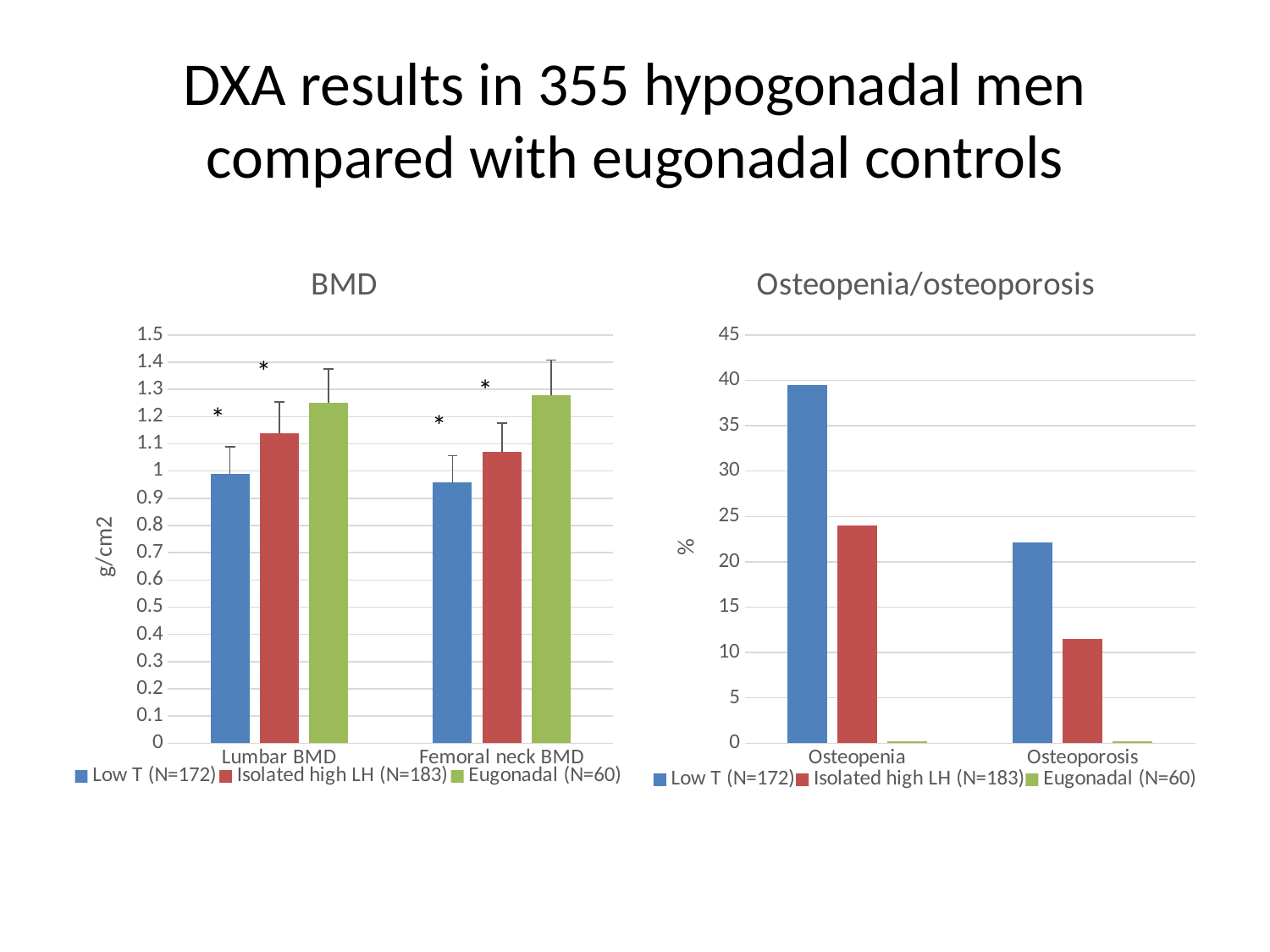
In the Osteopenia/osteoporosis chart, is the value for Low T (N=172) in Osteopenia greater or less than 35? greater In the Osteopenia/osteoporosis chart, what is the label on the y axis? % In the Osteopenia/osteoporosis chart, is the Low T (N=172) value larger for Osteopenia or for Osteoporosis? Osteopenia In the BMD chart, what is the label on the y axis? g/cm2 In the BMD chart, how many series does the legend list? 3 In the Osteopenia/osteoporosis chart, is the value for Isolated high LH (N=183) in Osteoporosis greater or less than 15? less In the BMD chart, which series has the lowest value for Lumbar BMD? Low T (N=172) In the BMD chart, what kind of chart is shown? bar chart In the BMD chart, is the value for Eugonadal (N=60) in Femoral neck BMD greater or less than 1.2? greater In the Osteopenia/osteoporosis chart, which series has the highest value for Osteopenia? Low T (N=172) In the BMD chart, which is larger for Lumbar BMD: Eugonadal (N=60) or Isolated high LH (N=183)? Eugonadal (N=60) In the Osteopenia/osteoporosis chart, how many categories are shown on the x axis? 2